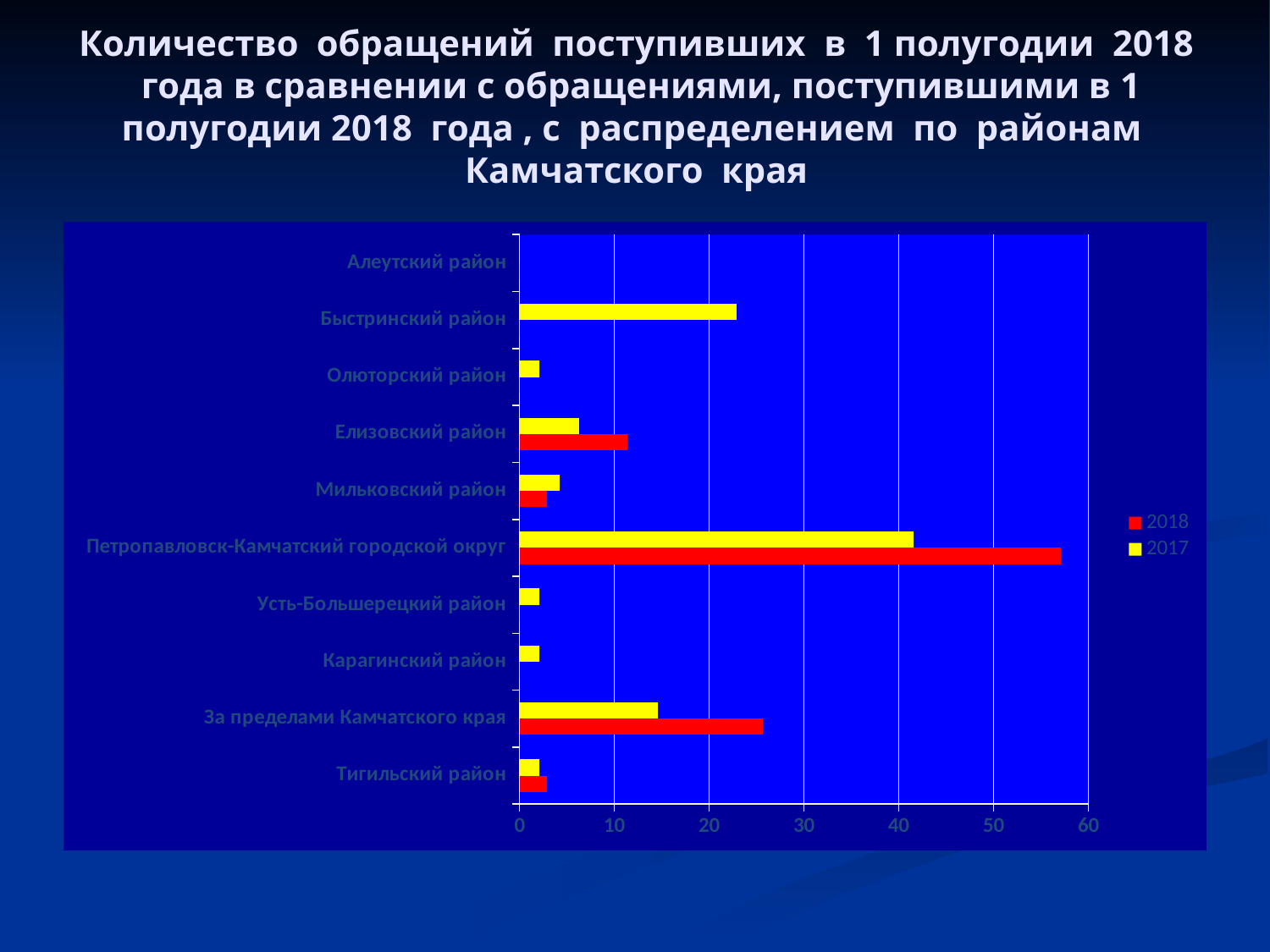
How many series does the chart legend list? 2 Is the 2018 value for Петропавловск-Камчатский городской округ greater or less than 50? greater Is the 2017 value for Быстринский район greater or less than 20? greater How many categories (districts) are listed on the vertical axis of the chart? 10 Which colour represents the 2017 series in the chart? yellow Which category has the highest value for the 2017 series? Петропавловск-Камчатский городской округ What kind of chart is shown on the slide? bar chart Is the 2017 value for Елизовский район greater or less than 10? less For Петропавловск-Камчатский городской округ, which series has the larger value, 2018 or 2017? 2018 Which category has the highest value for the 2018 series? Петропавловск-Камчатский городской округ For Быстринский район, which series has the larger value, 2018 or 2017? 2017